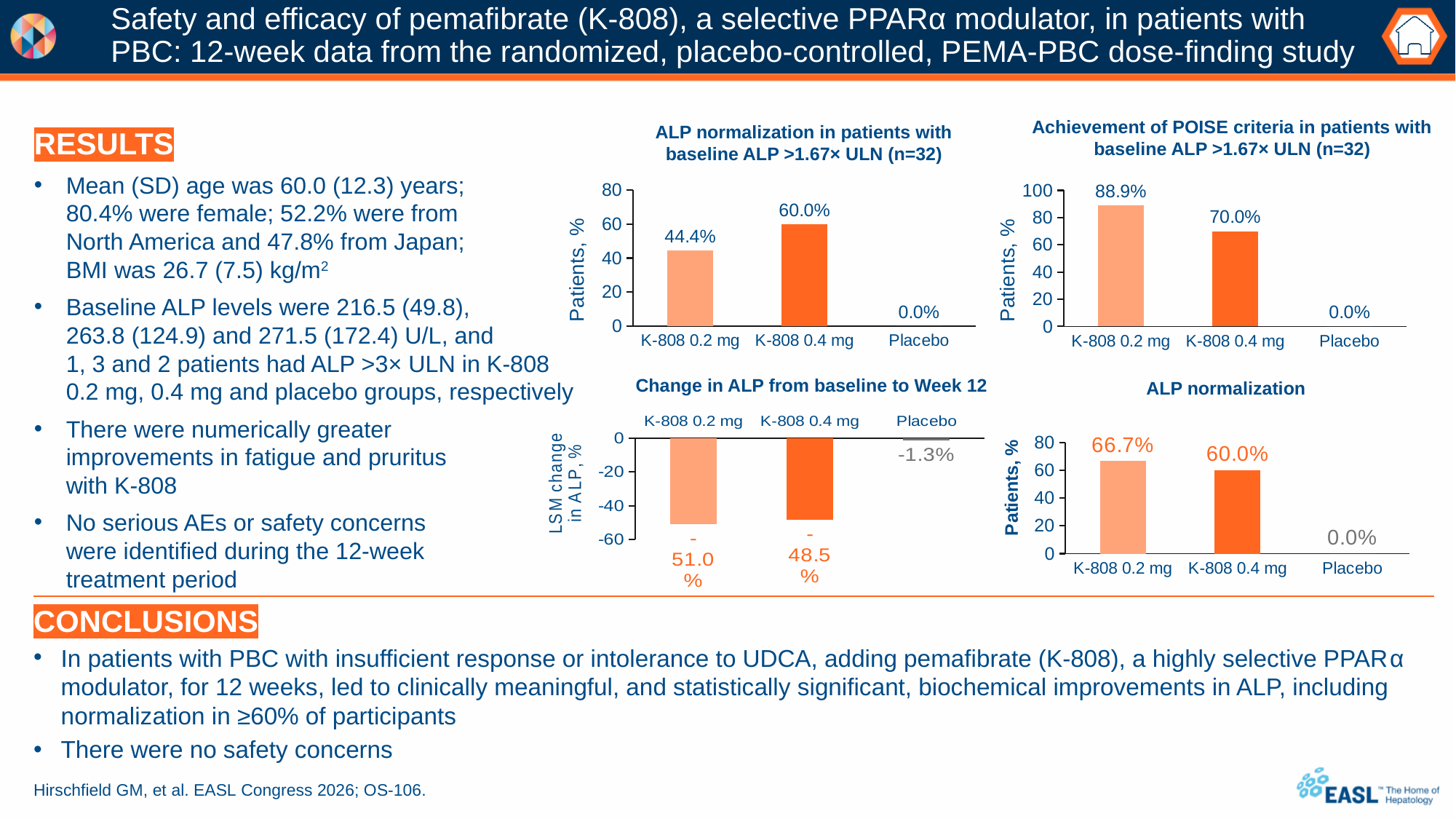
In the 'ALP normalization' chart (bottom right), what is the value for K-808 0.2 mg? 66.7% In the 'ALP normalization' chart (bottom right), which is larger, the value for K-808 0.2 mg or K-808 0.4 mg? K-808 0.2 mg What type of chart is the 'Achievement of POISE criteria in patients with baseline ALP >1.67× ULN (n=32)' chart? Bar chart In the 'Achievement of POISE criteria in patients with baseline ALP >1.67× ULN (n=32)' chart, what is the value for K-808 0.4 mg? 70.0% In the 'ALP normalization in patients with baseline ALP >1.67× ULN (n=32)' chart, what is the value for K-808 0.2 mg? 44.4% In the 'Achievement of POISE criteria in patients with baseline ALP >1.67× ULN (n=32)' chart, which group has the highest value? K-808 0.2 mg In the 'ALP normalization' chart (bottom right), which group has the lowest value? Placebo In the 'Change in ALP from baseline to Week 12' chart, what is the value for K-808 0.2 mg? -51.0% In the 'Achievement of POISE criteria in patients with baseline ALP >1.67× ULN (n=32)' chart, what is the difference between the K-808 0.2 mg and K-808 0.4 mg values? 18.9% How many groups are shown on the x axis of the 'Change in ALP from baseline to Week 12' chart? 3 In the 'Change in ALP from baseline to Week 12' chart, what is the value for Placebo? -1.3% In the 'ALP normalization in patients with baseline ALP >1.67× ULN (n=32)' chart, what is the value for K-808 0.4 mg? 60.0%